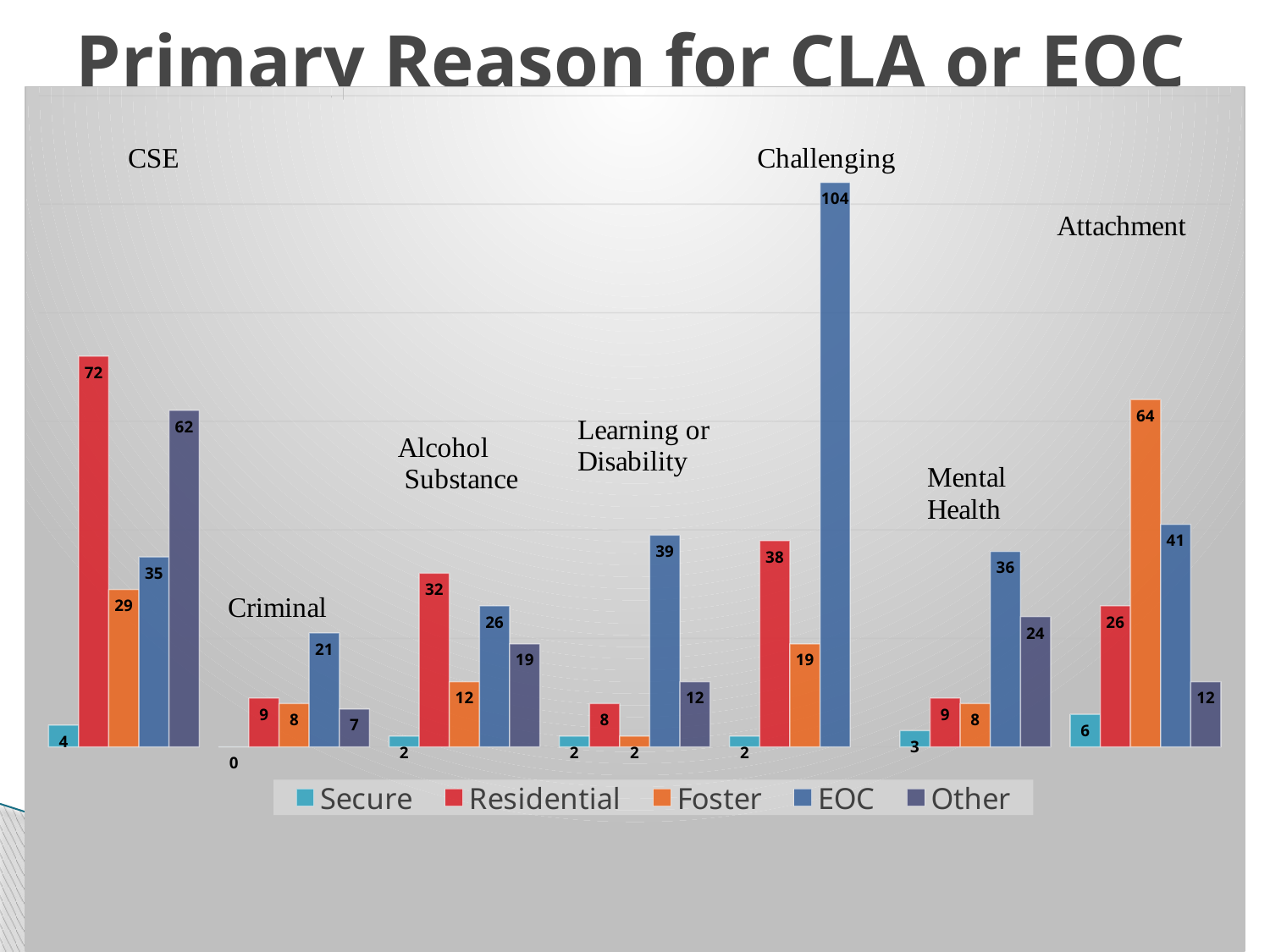
Which category has the highest EOC value? Challenging What is the EOC value for Challenging? 104 What is the difference between the Residential and Foster values for CSE? 43 Which category has the lowest Secure value? Criminal What is the Foster value for Attachment? 64 How many series does the legend list? 5 Which is larger for Mental Health: the EOC value or the Other value? EOC What is the Residential value for CSE? 72 What kind of chart is shown on the slide? Bar chart What is the title of the chart? Primary Reason for CLA or EOC What is the Other value for Alcohol Substance? 19 How many categories are shown on the chart? 7